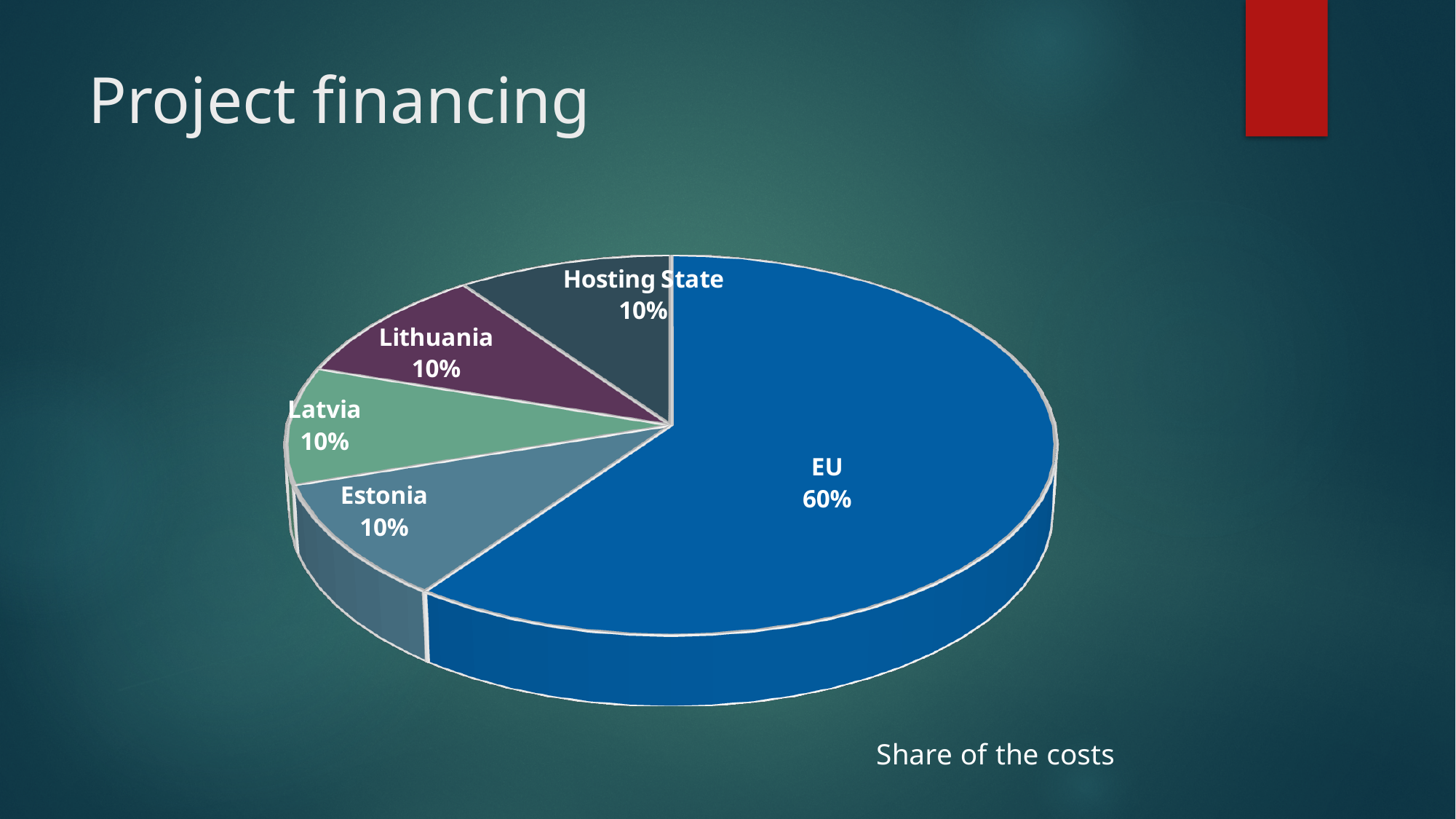
What share of the costs does Estonia cover? 10% What is the difference between the EU's share and Latvia's share? 50% How many slices does the pie chart have? 5 Which is larger, the EU's share or Estonia's share? EU What share of the costs does Lithuania cover? 10% What kind of chart is shown on the slide? Pie chart What share of the costs does the EU cover? 60% Which contributor has the largest share of the costs? EU What caption appears below the pie chart? Share of the costs What is the title of the slide containing the chart? Project financing What is the combined share of Estonia, Latvia and Lithuania? 30% What share of the costs does the Hosting State cover? 10%